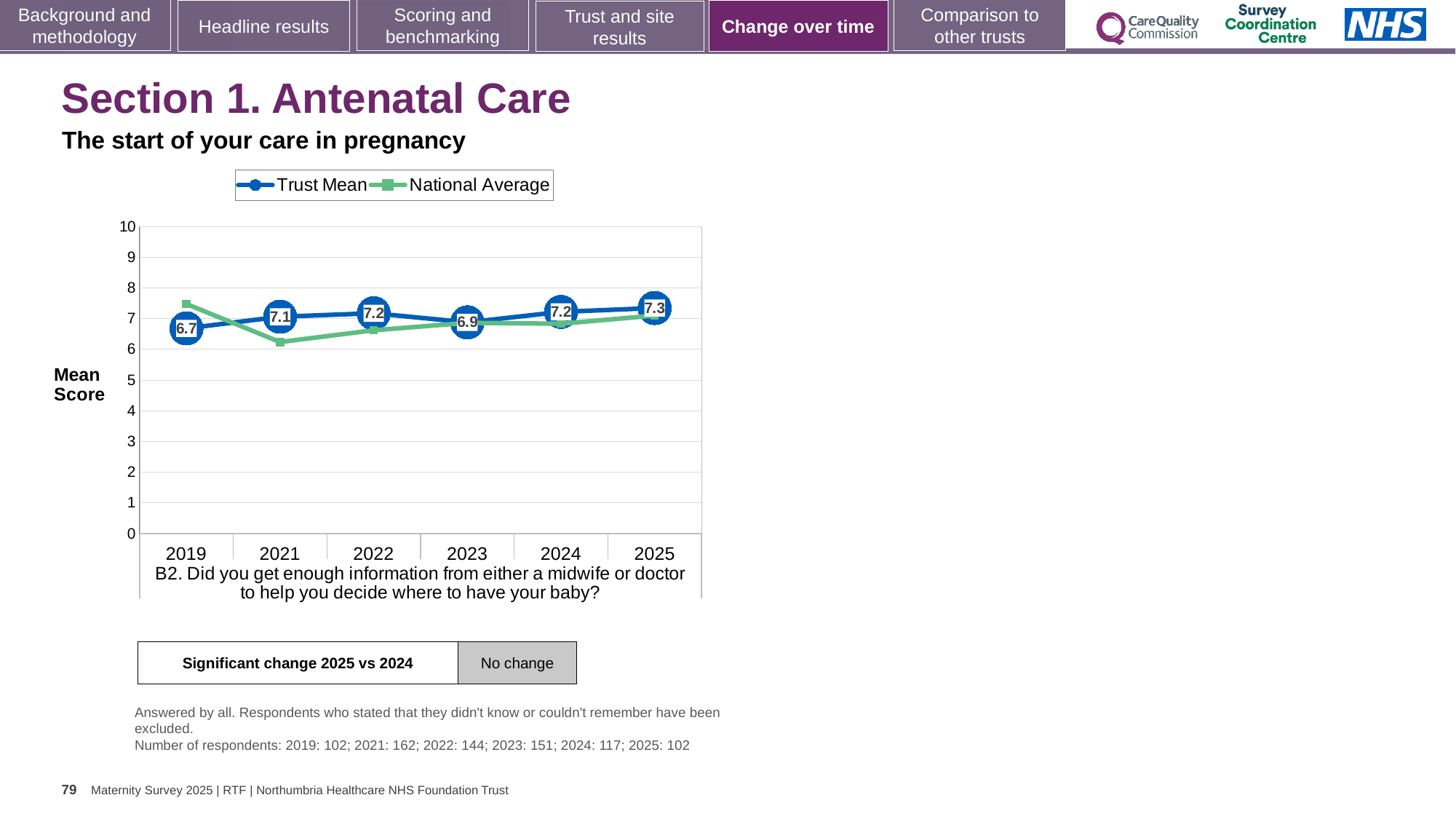
Is the National Average value for 2021 greater or less than 7? less What is the Trust Mean score for 2019? 6.7 Is the National Average value for 2019 greater or less than 7? greater In which year is the Trust Mean highest? 2025 How many years are shown on the x axis? 6 What is the Trust Mean score for 2025? 7.3 What is the difference between the Trust Mean in 2025 and in 2019? 0.6 What is the Trust Mean score for 2023? 6.9 What kind of chart is shown on the slide? Line chart How many series does the legend list? 2 In which year is the Trust Mean lowest? 2019 Which year has the larger Trust Mean, 2022 or 2023? 2022